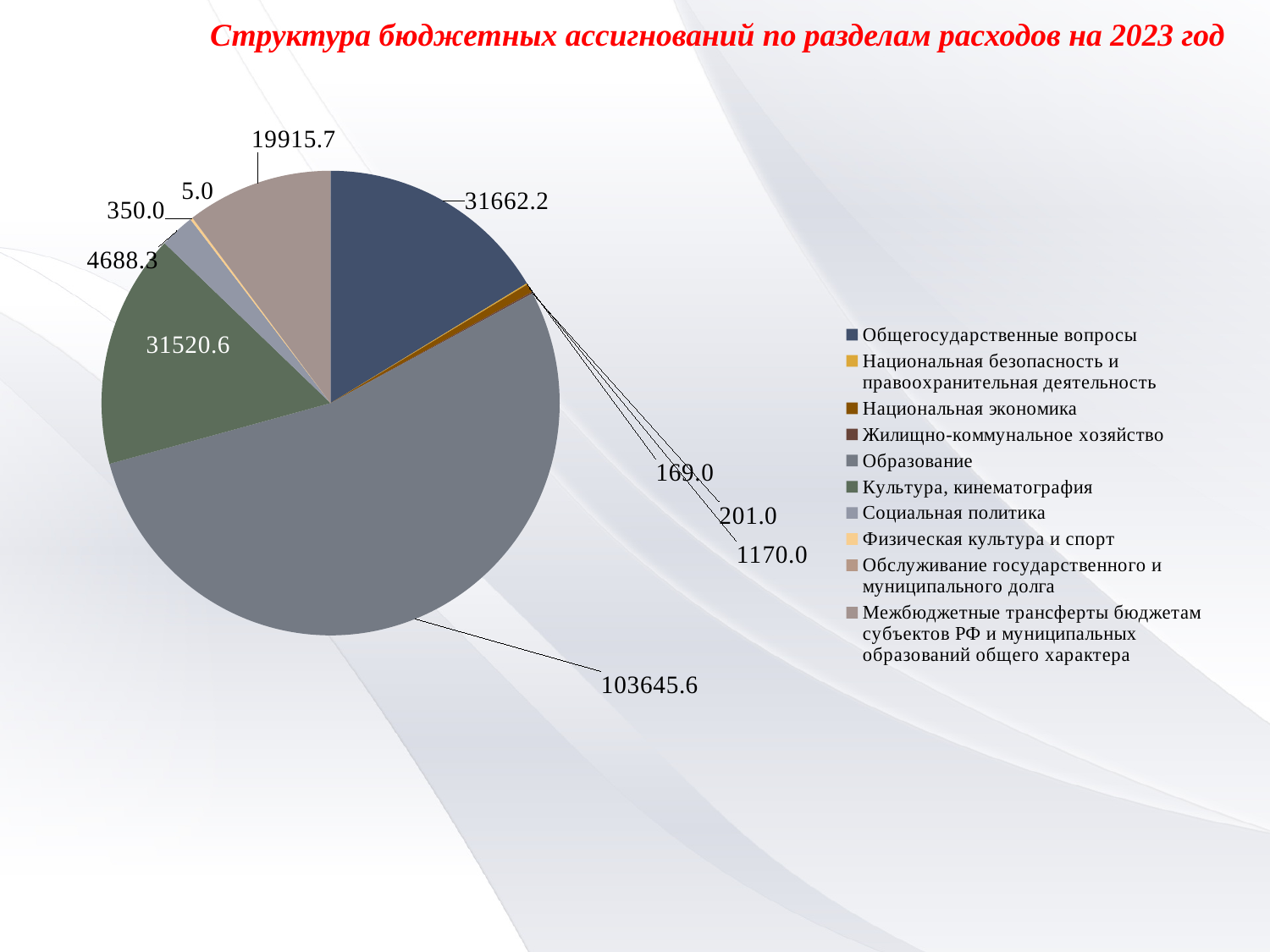
What type of chart is shown on the slide? Pie chart Which is larger: the value for Общегосударственные вопросы or the value for Культура, кинематография? Общегосударственные вопросы What is the value for Межбюджетные трансферты бюджетам субъектов РФ и муниципальных образований общего характера? 19915.7 What is the value for Общегосударственные вопросы? 31662.2 Which category has the largest slice of the pie? Образование What is the difference between the values for Общегосударственные вопросы and Культура, кинематография? 141.6 What is the value for Социальная политика? 4688.3 How many categories does the legend list? 10 What is the value for Культура, кинематография? 31520.6 What is the title of the chart? Структура бюджетных ассигнований по разделам расходов на 2023 год Which category has the smallest value? Обслуживание государственного и муниципального долга What is the value for Образование? 103645.6